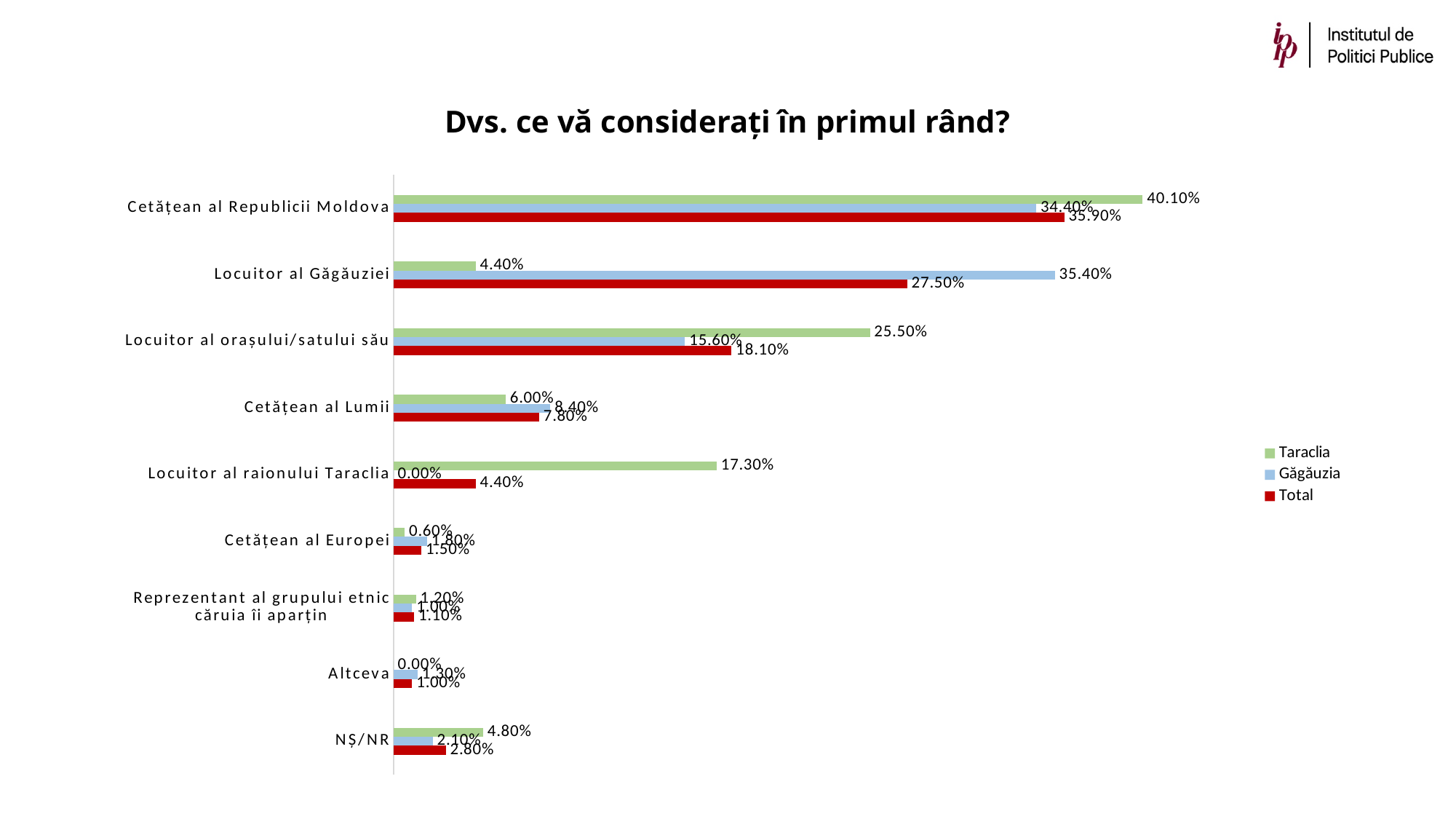
What is the Taraclia value for "Cetățean al Republicii Moldova"? 40.10% What is the Taraclia value for "Locuitor al raionului Taraclia"? 17.30% What kind of chart is shown on the slide? Bar chart What is the Găgăuzia value for "Locuitor al Găgăuziei"? 35.40% Which is larger for "Cetățean al Lumii": the Taraclia value or the Găgăuzia value? Găgăuzia How many categories are shown on the chart? 9 What is the Total value for "Locuitor al orașului/satului său"? 18.10% What is the difference between the Taraclia and Găgăuzia values for "Locuitor al Găgăuziei"? 31.00% Which category has the lowest Taraclia value? Altceva Which series is shown in red? Total Which category has the highest Total value? Cetățean al Republicii Moldova How many series does the legend list? 3